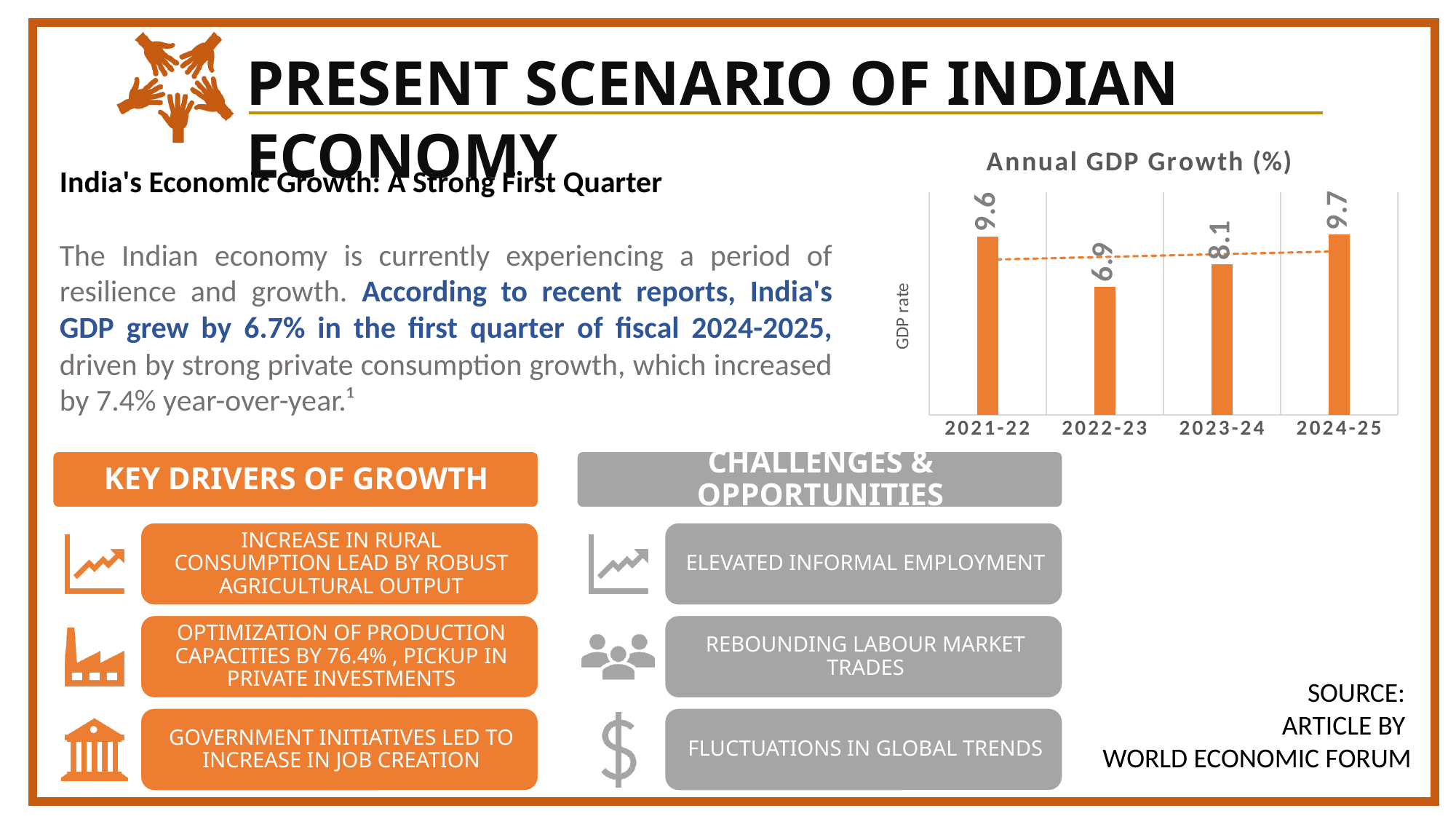
What is the Annual GDP Growth (%) value for 2024-25? 9.7 What kind of chart is the Annual GDP Growth (%) chart? Bar chart What is the Annual GDP Growth (%) value for 2023-24? 8.1 What is the Annual GDP Growth (%) value for 2022-23? 6.9 How many years are shown in the Annual GDP Growth (%) chart? 4 Which year has the lowest Annual GDP Growth (%)? 2022-23 Does the GDP growth rise or fall from 2022-23 to 2024-25? Rise What is the Annual GDP Growth (%) value for 2021-22? 9.6 What is the difference between the GDP growth values for 2021-22 and 2022-23? 2.7 Which year has the highest Annual GDP Growth (%)? 2024-25 Which is larger, the GDP growth for 2023-24 or for 2022-23? 2023-24 What is the title of the chart on the slide? Annual GDP Growth (%)